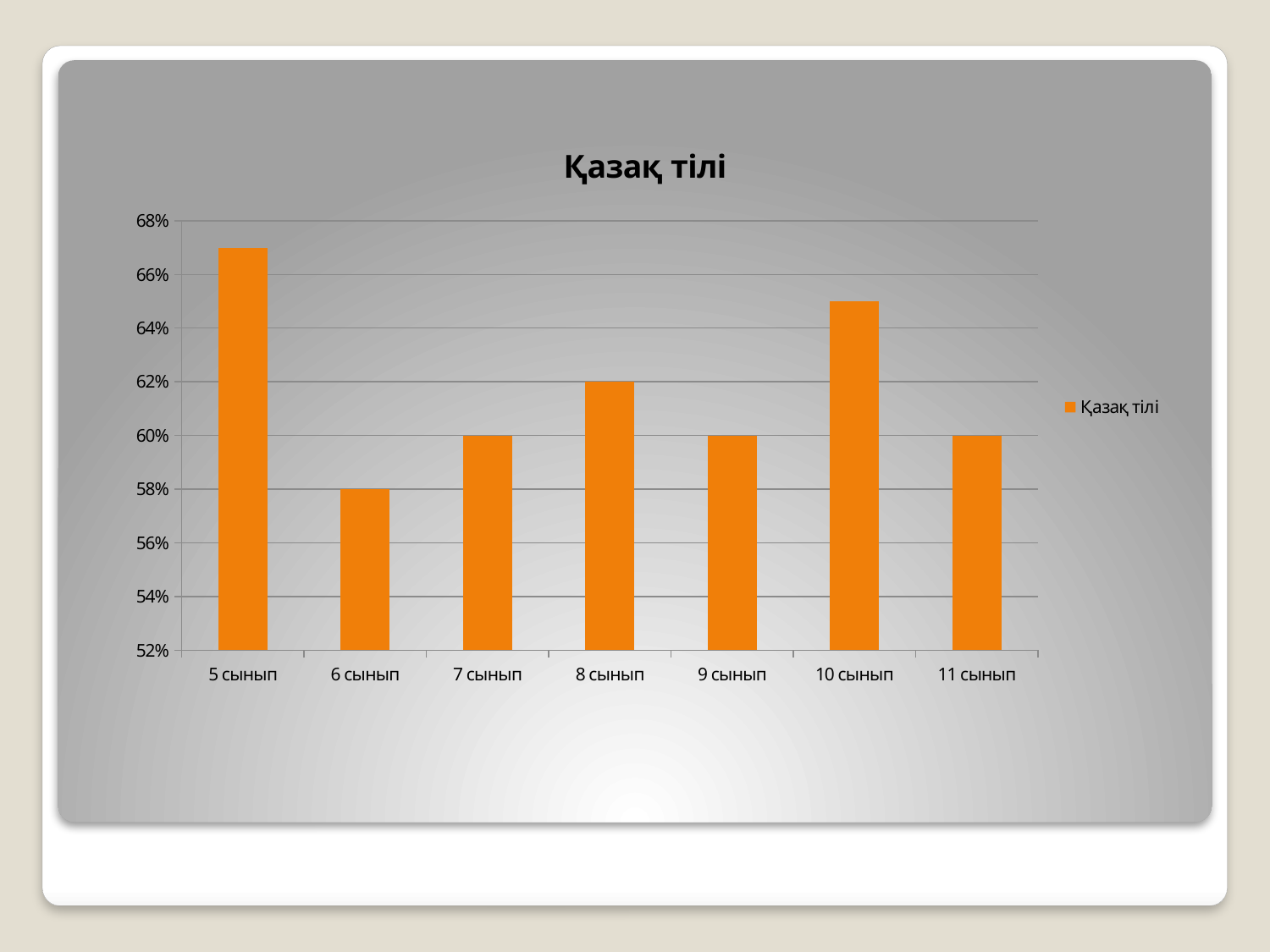
What is the value for 7 сынып? 60% Is the value for 5 сынып greater or less than 66%? greater What is the value for 6 сынып? 58% What is the difference between the values for 8 сынып and 6 сынып? 4% What is the value for 11 сынып? 60% Which category has the lowest value? 6 сынып What is the value for 8 сынып? 62% How many categories are shown on the x axis? 7 What kind of chart is shown on the slide? Bar chart Which category has the highest value? 5 сынып Is the value for 10 сынып greater or less than 64%? greater Which is larger, the value for 8 сынып or the value for 9 сынып? 8 сынып